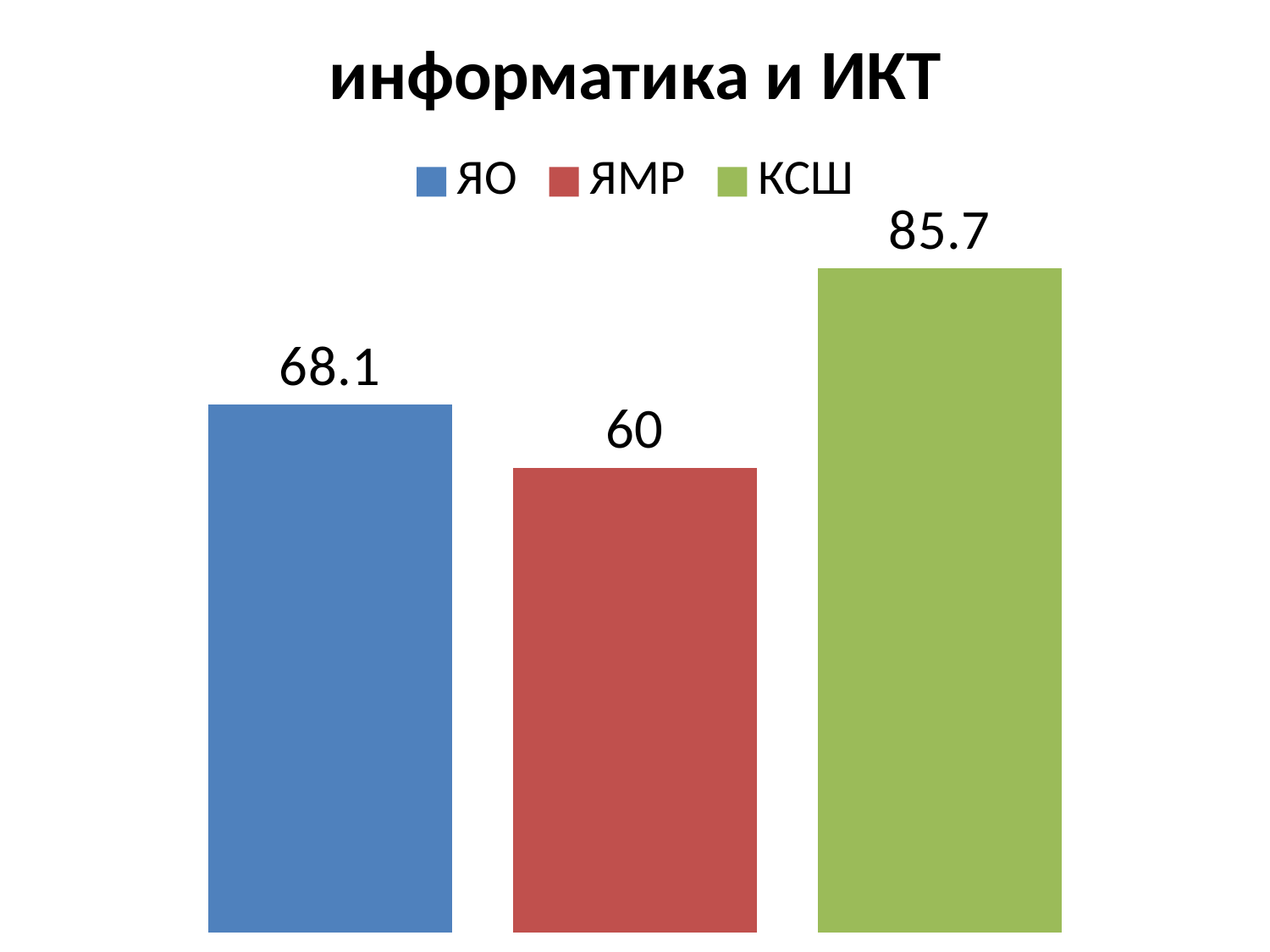
What is the value for КСШ? 85.7 Which series has the lowest value? ЯМР What kind of chart is shown on the slide? bar chart How many series does the legend list? 3 How many bars are shown in the chart? 3 What is the title of the chart? информатика и ИКТ What is the value for ЯМР? 60 Which series has the highest value? КСШ What is the difference between the values for КСШ and ЯО? 17.6 What is the value for ЯО? 68.1 Which is larger, the value for ЯО or the value for ЯМР? ЯО What is the difference between the values for ЯО and ЯМР? 8.1